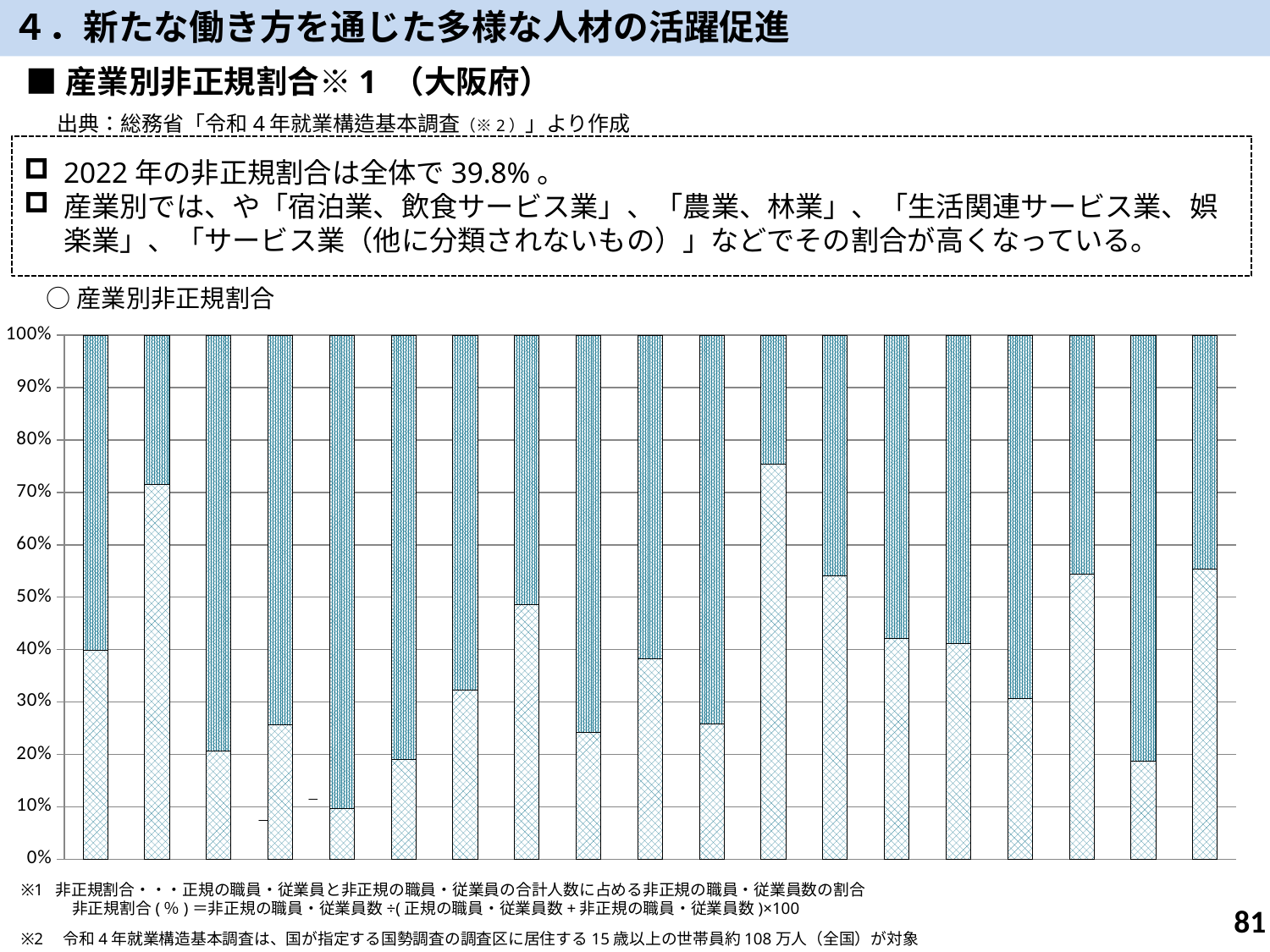
What kind of chart is shown on the slide? bar chart Is the lower (cross-hatched) segment of the seventh bar from the left greater or less than 40%? less Which has the larger lower (cross-hatched) segment: the leftmost bar or the third bar from the left? the leftmost bar Is the lower (cross-hatched) segment of the second bar from the left greater or less than 60%? greater Which bar has the smallest lower (cross-hatched) segment? the fifth bar from the left Is the lower (cross-hatched) segment of the leftmost bar greater or less than 30%? greater What is the highest value shown on the chart's vertical axis? 100% How many bars (categories) are plotted in the chart? 19 What is the title printed above the chart? 産業別非正規割合